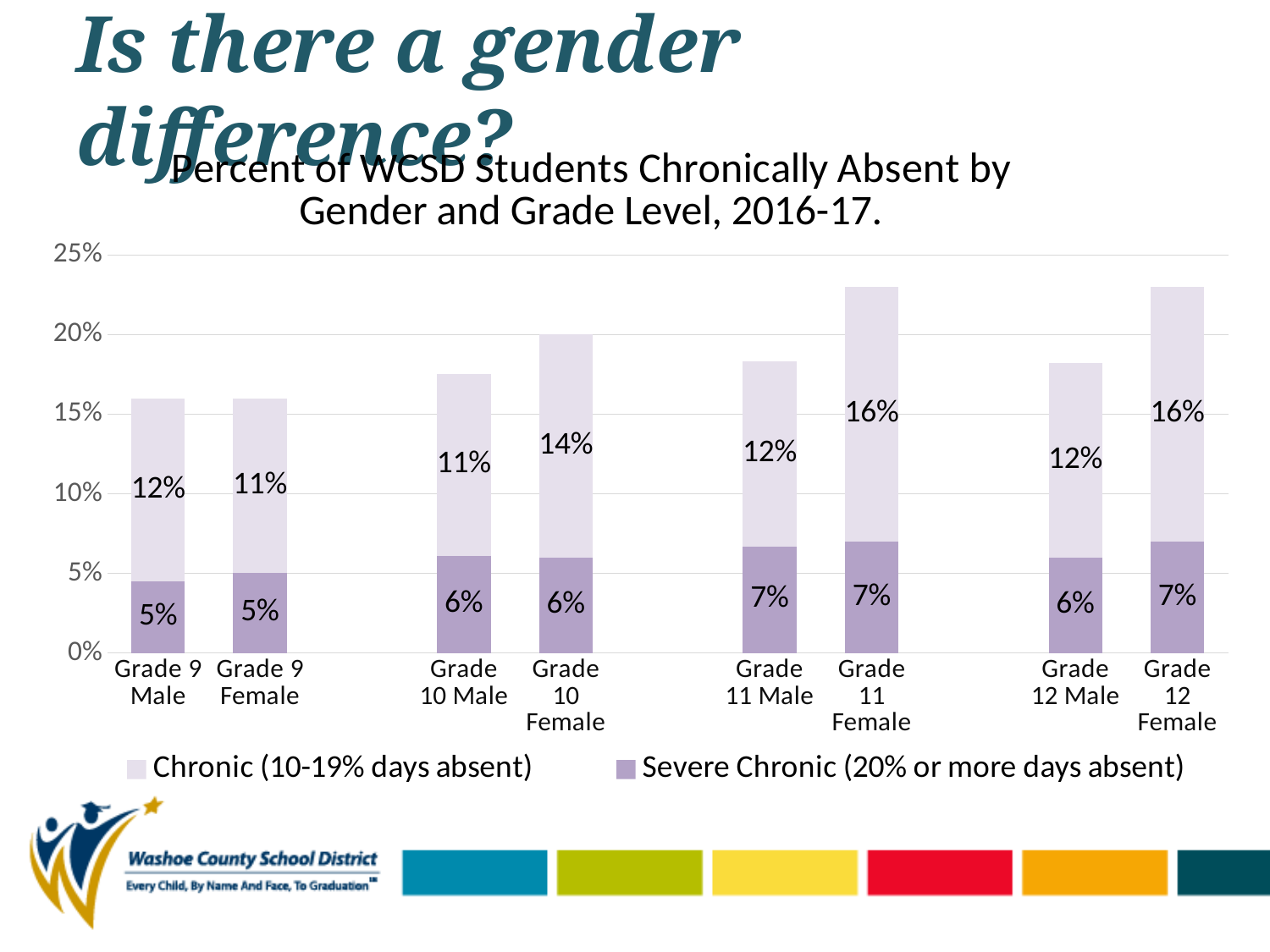
What is the total height of the stacked bar for Grade 11 Female? 23% Which has the larger Chronic (10-19% days absent) value, Grade 10 Male or Grade 10 Female? Grade 10 Female What is the Severe Chronic (20% or more days absent) value for Grade 11 Male? 7% What is the Chronic (10-19% days absent) value for Grade 9 Female? 11% What is the title of the chart? Percent of WCSD Students Chronically Absent by Gender and Grade Level, 2016-17. How many gender-and-grade categories are plotted along the x axis? 8 What is the Severe Chronic (20% or more days absent) value for Grade 9 Male? 5% What is the difference between the Chronic (10-19% days absent) values for Grade 12 Female and Grade 12 Male? 4% How many series does the legend list? 2 What is the Chronic (10-19% days absent) value for Grade 10 Female? 14% Is the total stacked value for Grade 9 Male greater or less than 20%? less What type of chart is shown on the slide? Stacked bar chart